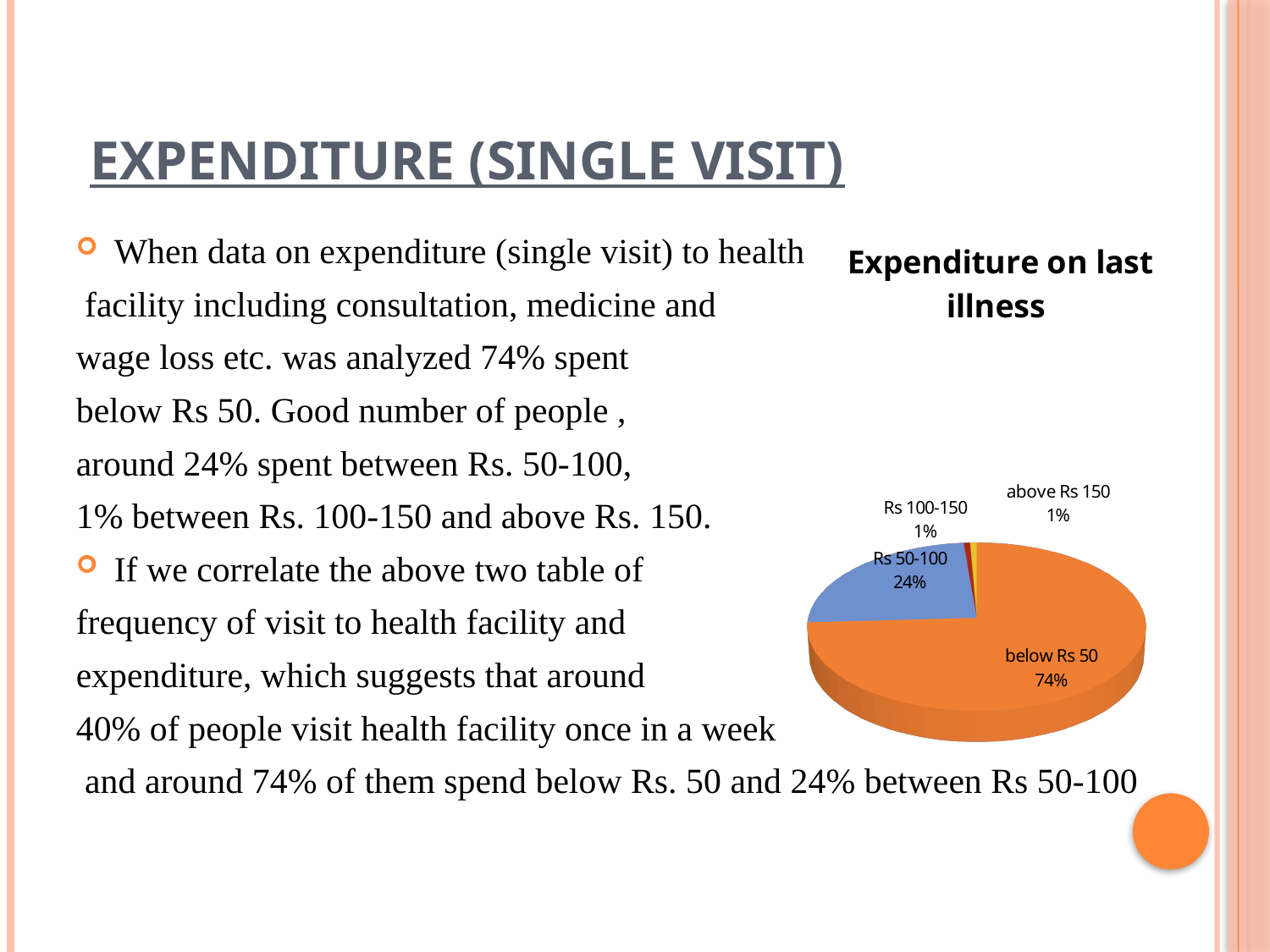
What is the title of the chart? Expenditure on last illness Which category has the largest slice of the pie? below Rs 50 Which is larger, the 'Rs 50-100' slice or the 'above Rs 150' slice? Rs 50-100 How many slices does the pie chart have? 4 What share of the pie is labelled 'Rs 100-150'? 1% What share of the pie is labelled 'below Rs 50'? 74% What is the difference in percentage points between the 'below Rs 50' slice and the 'Rs 50-100' slice? 50 What share of the pie is labelled 'Rs 50-100'? 24% What colour is the 'below Rs 50' slice? orange What kind of chart is shown on the slide? pie chart What is the combined share of the 'Rs 100-150' and 'above Rs 150' slices? 2%